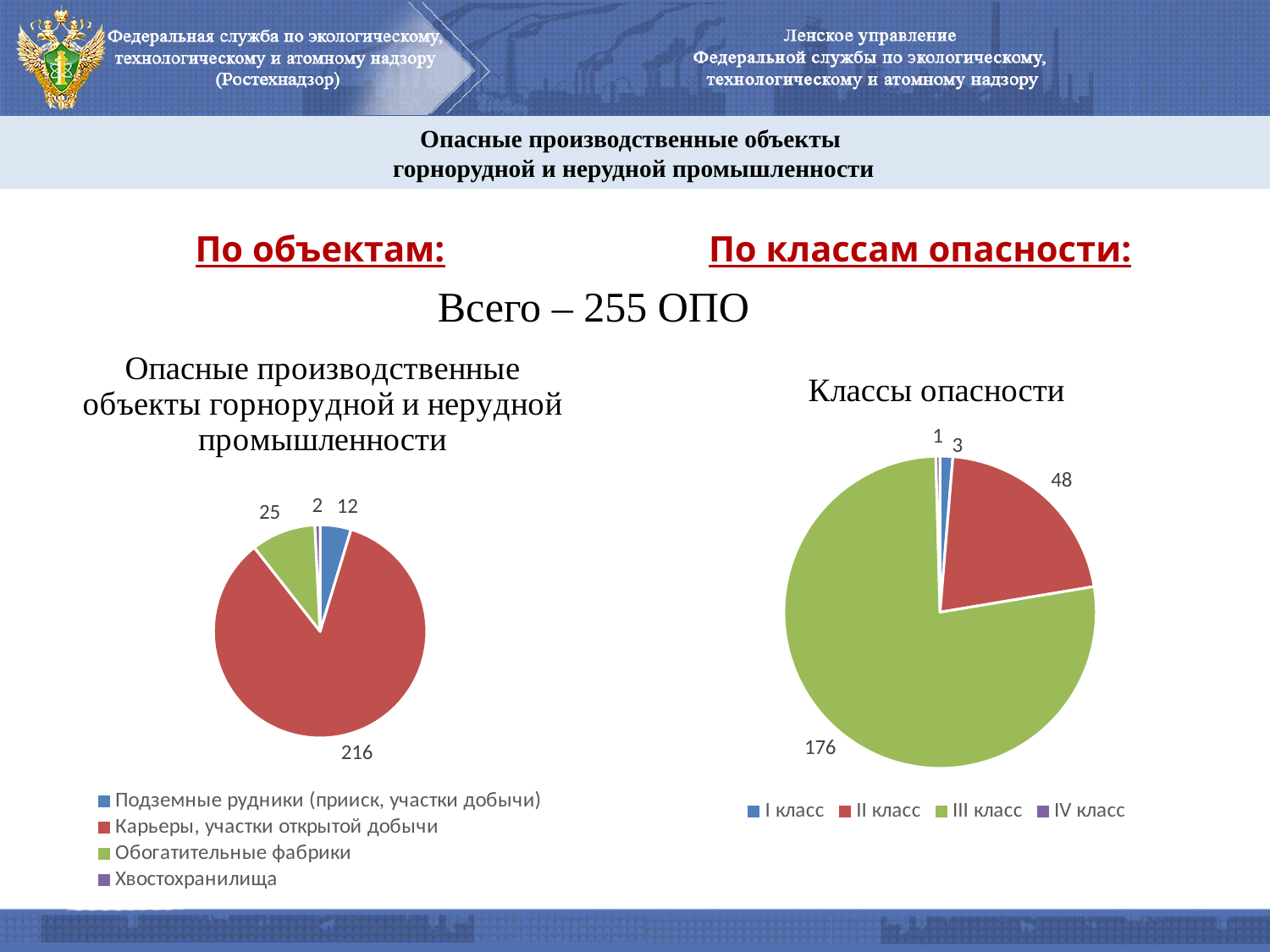
In the left pie chart (Опасные производственные объекты горнорудной и нерудной промышленности), what is the value for Карьеры, участки открытой добычи? 216 In the left pie chart, which category has the largest slice? Карьеры, участки открытой добычи In the left pie chart, what is the value for Обогатительные фабрики? 25 In the right pie chart (Классы опасности), which class has the largest slice? III класс How many categories does the legend of the left pie chart list? 4 In the left pie chart, what is the value for Подземные рудники (прииск, участки добычи)? 12 What type of chart is the right chart titled Классы опасности? Pie chart In the left pie chart, which category has the smallest slice? Хвостохранилища In the right pie chart (Классы опасности), what is the value for III класс? 176 In the left pie chart, what is the difference between the values for Обогатительные фабрики and Подземные рудники? 13 In the right pie chart (Классы опасности), what is the difference between the values for III класс and II класс? 128 In the right pie chart (Классы опасности), what is the value for II класс? 48